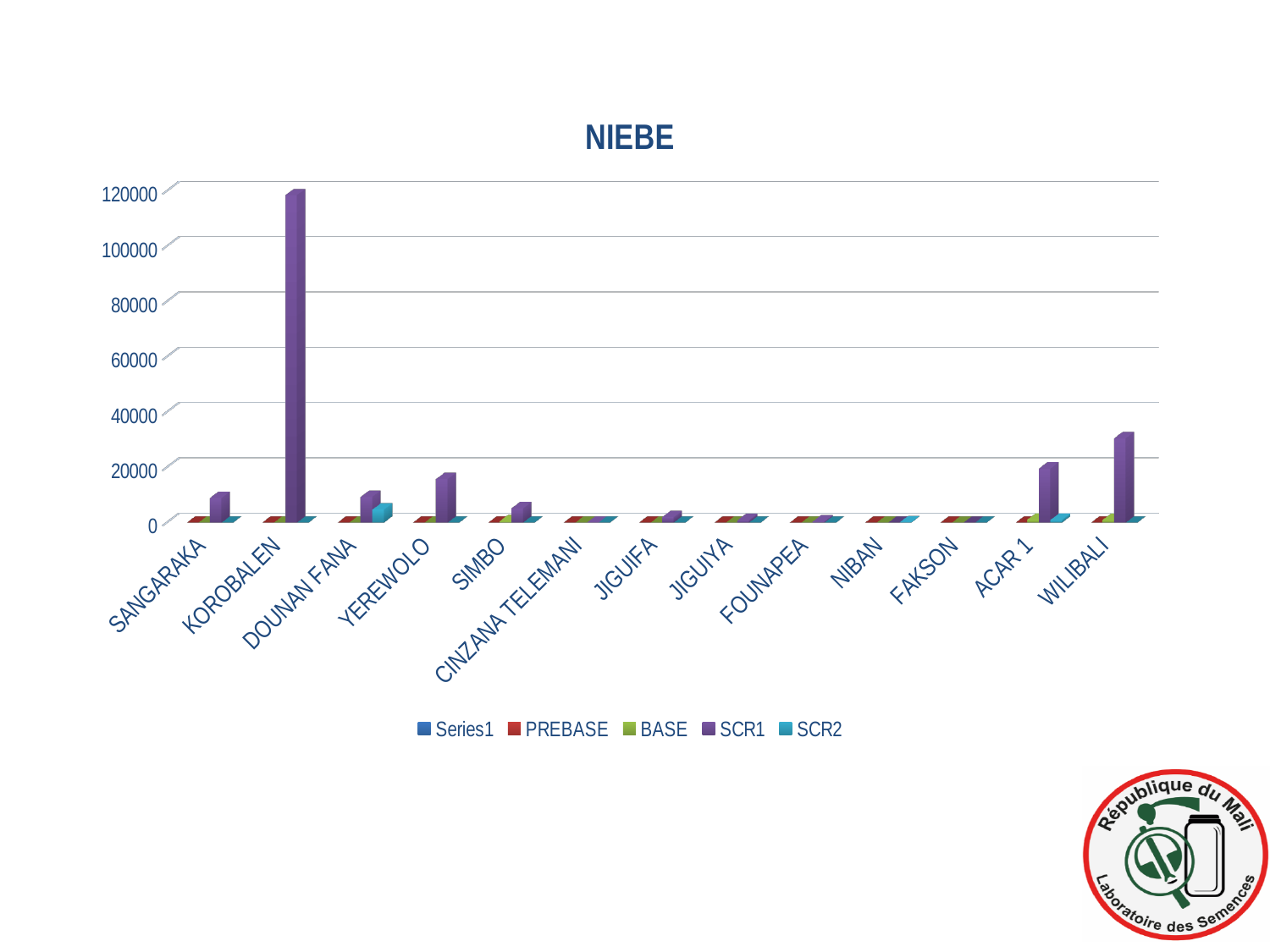
Is the SCR1 value for KOROBALEN greater or less than 100000? greater Which has the larger SCR1 value, WILIBALI or YEREWOLO? WILIBALI What kind of chart is shown on the slide? bar chart Which series is listed first in the legend? Series1 Is the SCR1 value for YEREWOLO greater or less than 20000? less What is the title of the chart? NIEBE Is the SCR1 value for WILIBALI greater or less than 20000? greater How many series does the legend list? 5 How many categories are shown on the x axis? 13 Which category has the highest SCR1 value? KOROBALEN Which has the larger SCR1 value, KOROBALEN or WILIBALI? KOROBALEN